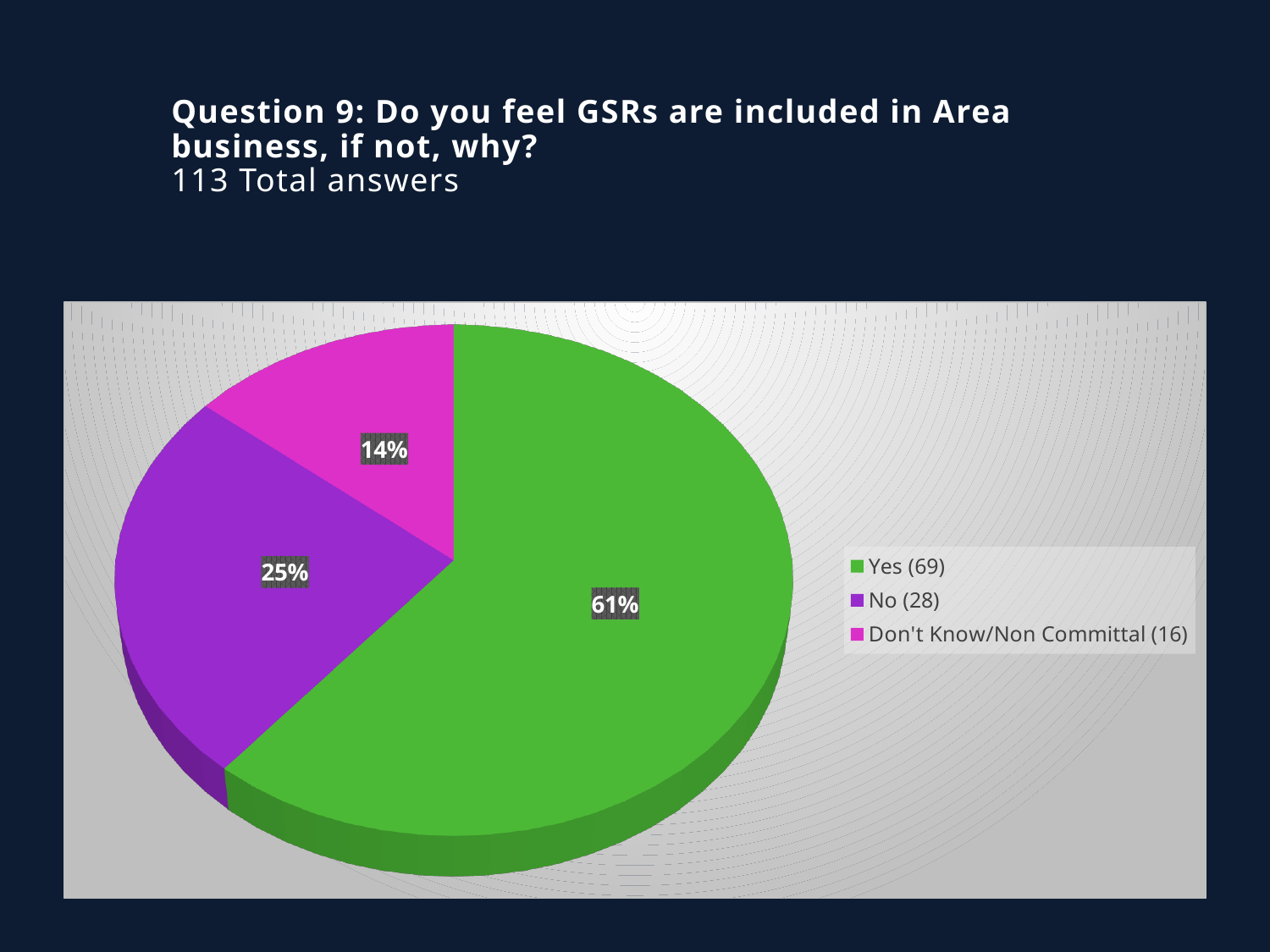
What percentage of the pie does the "Yes" slice represent? 61% How many categories does the pie chart have? 3 What is the difference in percentage points between the "Yes" slice and the "No" slice? 36 percentage points What percentage of the pie does the "No" slice represent? 25% Which colour represents the "No" category in the pie chart? purple What percentage of the pie does the "Don't Know/Non Committal" slice represent? 14% How many responses does the legend show for "Yes"? 69 What type of chart is shown on the slide? pie chart How many responses does the legend show for "No"? 28 Which category has the largest slice of the pie? Yes How many responses does the legend show for "Don't Know/Non Committal"? 16 Which category has the smallest slice of the pie? Don't Know/Non Committal